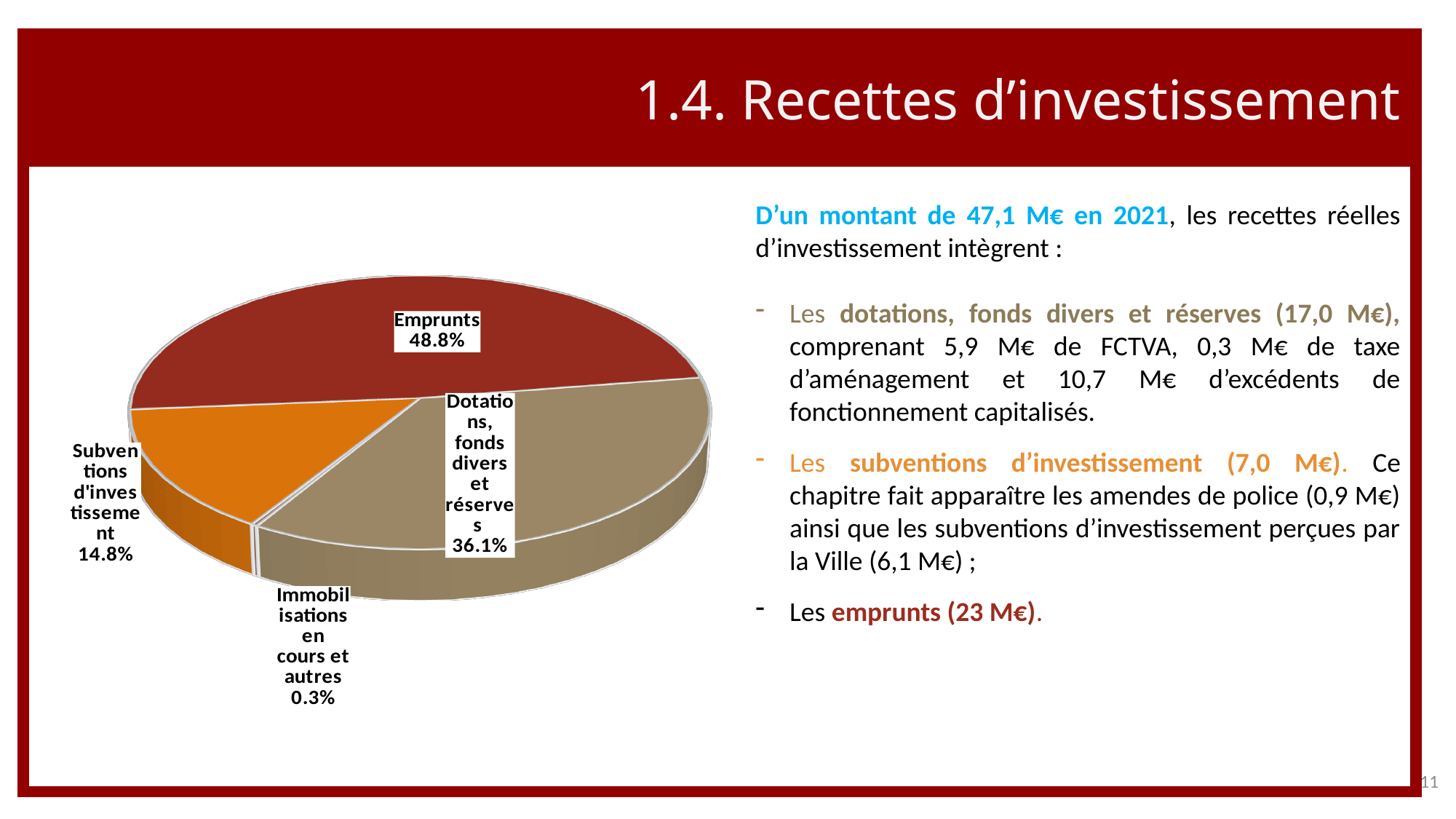
What share of the pie does Subventions d'investissement represent? 14.8% What colour is the Subventions d'investissement slice? Orange What is the combined share of Emprunts and Subventions d'investissement? 63.6% What share of the pie does Dotations, fonds divers et réserves represent? 36.1% What share of the pie does Immobilisations en cours et autres represent? 0.3% What type of chart is shown on the slide? Pie chart Which slice of the pie chart is the smallest? Immobilisations en cours et autres Which is larger: Subventions d'investissement or Dotations, fonds divers et réserves? Dotations, fonds divers et réserves What is the difference in percentage points between Emprunts and Dotations, fonds divers et réserves? 12.7 How many slices does the pie chart have? 4 Which slice of the pie chart is the largest? Emprunts